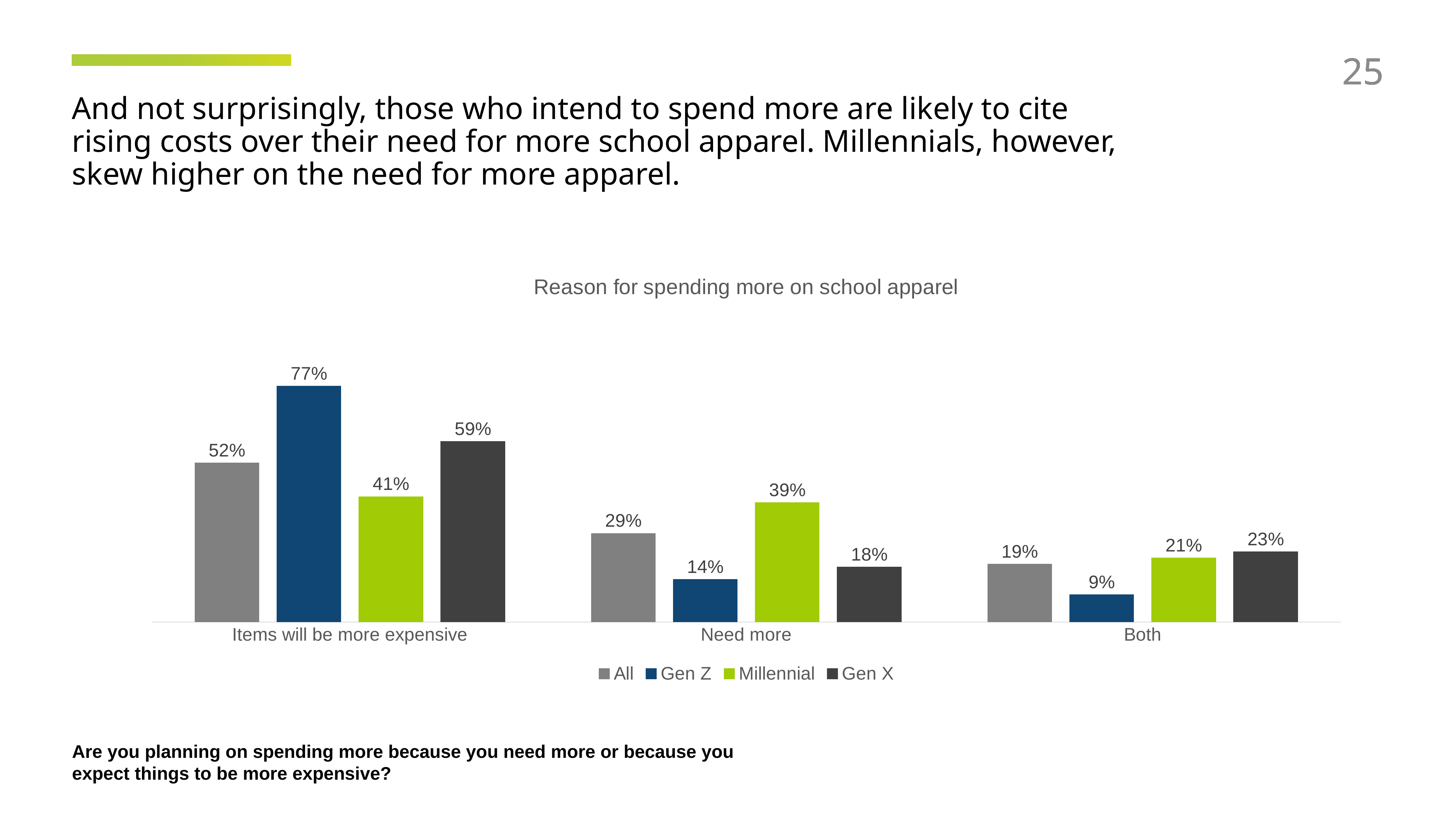
What kind of chart is shown on the slide? Bar chart How many categories are shown on the x axis? 3 What is the difference between the Gen Z and Millennial values in the 'Items will be more expensive' category? 36% What is the value for Millennial in the 'Need more' category? 39% What is the title of the chart? Reason for spending more on school apparel What is the value for Gen X in the 'Both' category? 23% Which series has the lowest value in the 'Both' category? Gen Z What is the value for All in the 'Need more' category? 29% How many series does the legend list? 4 Which series has the highest value in the 'Items will be more expensive' category? Gen Z What is the value for Gen Z in the 'Items will be more expensive' category? 77% Which is larger: the Millennial value for 'Need more' or the Gen X value for 'Need more'? Millennial